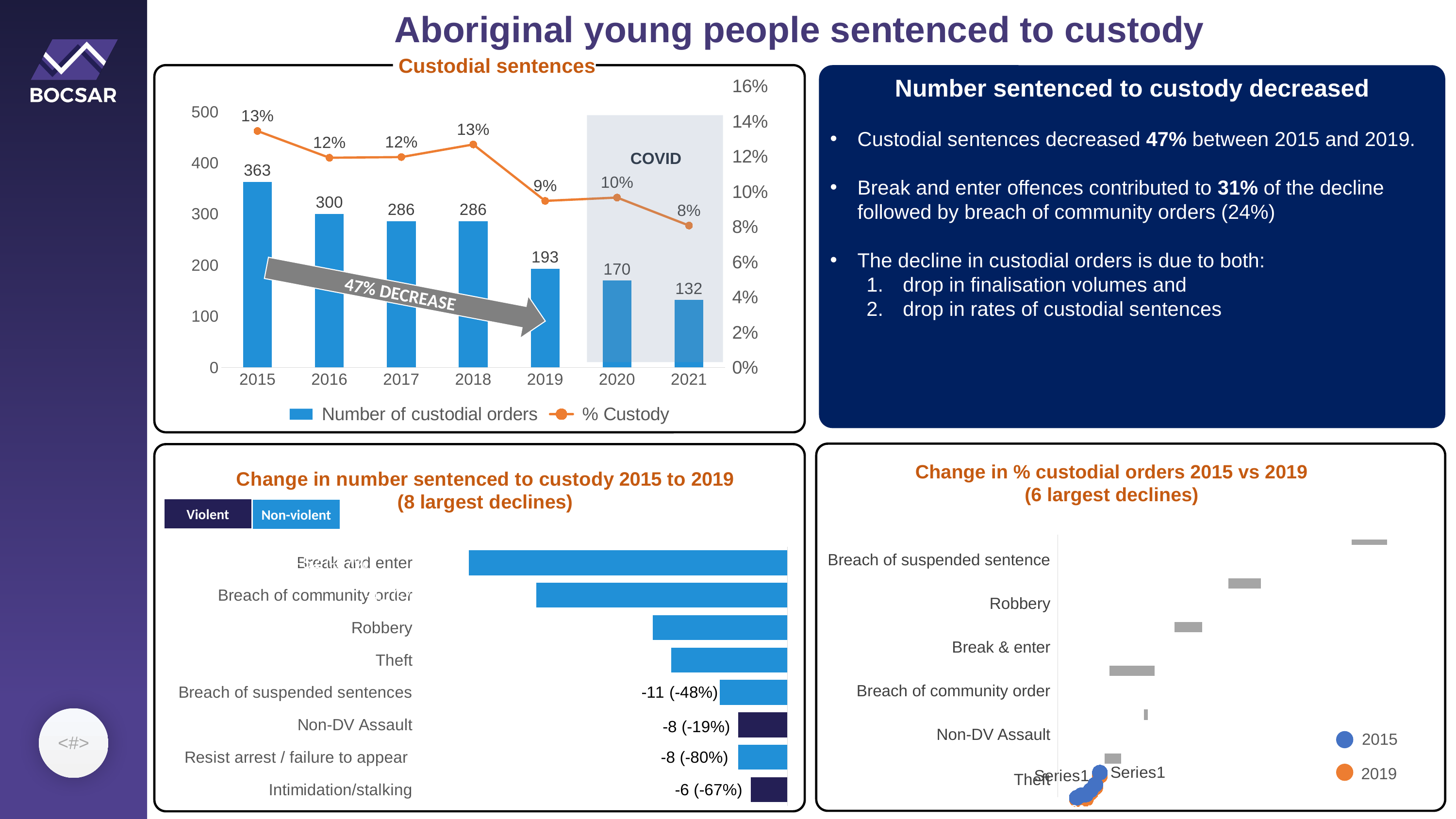
In the 'Custodial sentences' chart, which year had the lowest number of custodial orders? 2021 In the 'Custodial sentences' chart, how many series does the legend list? 2 In the 'Change in number sentenced to custody 2015 to 2019' chart, how many offence categories are listed? 8 In the 'Custodial sentences' chart, what is the difference between the number of custodial orders in 2015 and in 2021? 231 In the 'Custodial sentences' chart, how many years are shown on the x axis? 7 In the 'Custodial sentences' chart, what was the % Custody value in 2019? 9% In the 'Change in number sentenced to custody 2015 to 2019' chart, what is the value shown for Breach of suspended sentences? -11 (-48%) In the 'Custodial sentences' chart, which years are shaded and labelled COVID? 2020 and 2021 In the 'Custodial sentences' chart, which year had more custodial orders, 2016 or 2019? 2016 In the 'Custodial sentences' chart, does the number of custodial orders rise or fall from 2015 to 2021? Fall In the 'Custodial sentences' chart, which year had the highest number of custodial orders? 2015 In the 'Custodial sentences' chart, what was the number of custodial orders in 2015? 363